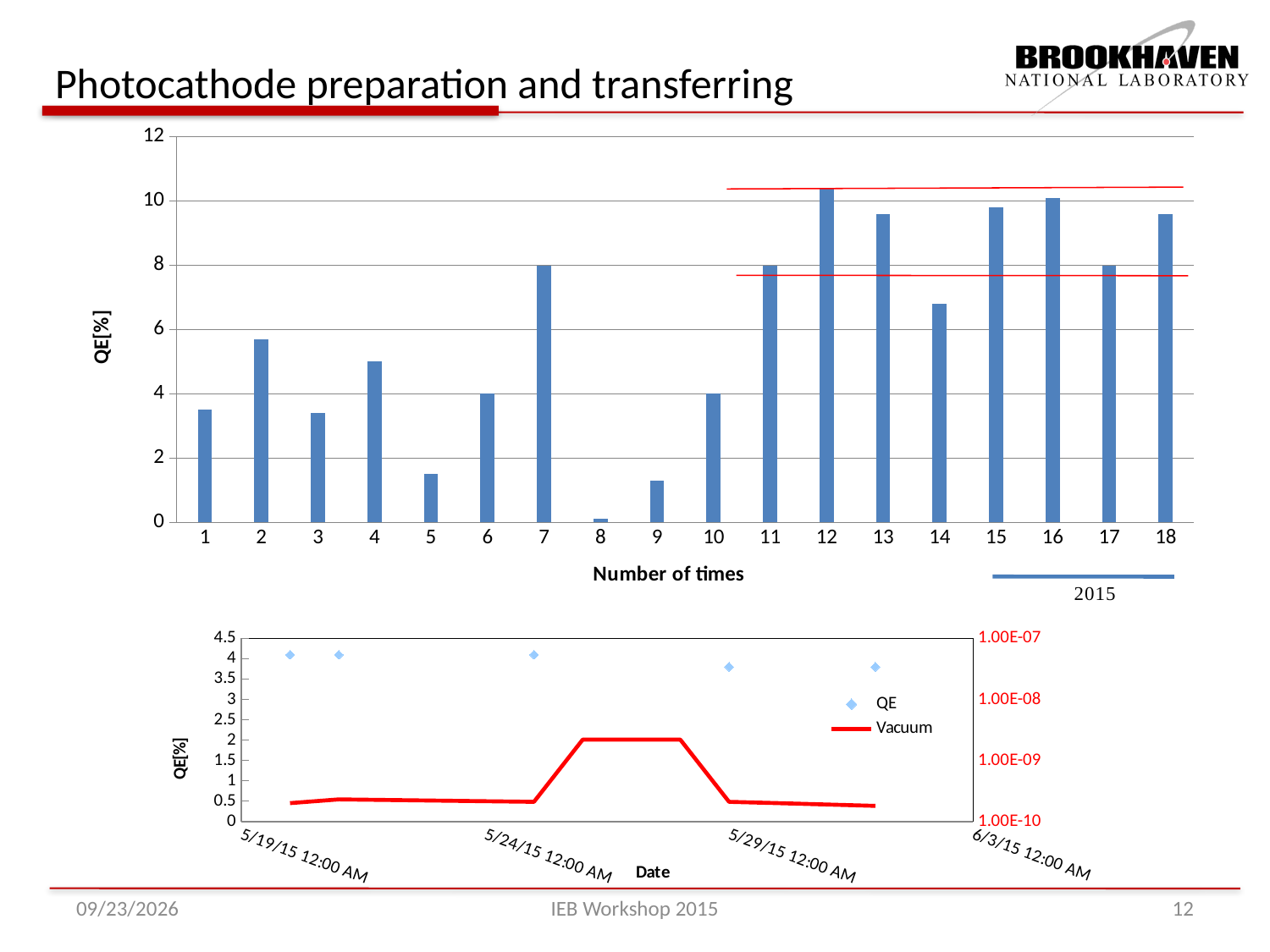
In the top chart, is the QE[%] value for number of times 14 greater or less than 6? greater How many series does the legend of the bottom chart list? 2 In the top chart, is the QE[%] value for number of times 12 greater or less than 10? greater In the top chart, which has the larger QE[%]: number of times 13 or number of times 14? 13 What is the legend entry shown for the top chart? 2015 In the top chart, is the QE[%] value for number of times 2 greater or less than 4? greater In the top chart, which has the larger QE[%]: number of times 2 or number of times 3? 2 In the top chart, how many bars (number of times) are plotted along the x axis? 18 What kind of chart is the top chart on the slide? bar chart In the top chart, which number of times has the lowest QE[%]? 8 What is the x-axis title of the bottom chart? Date